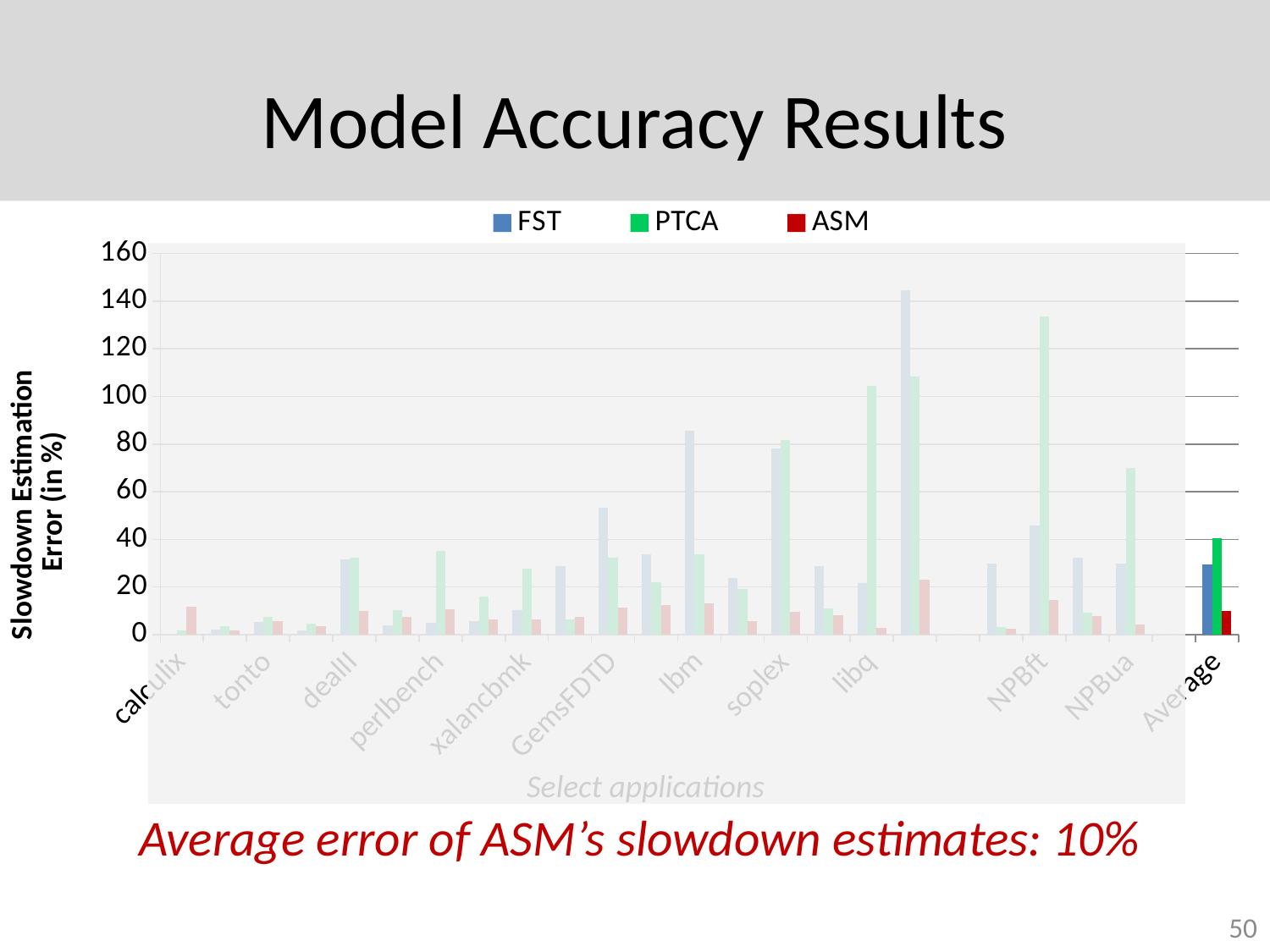
For the Average category, which series has the highest bar? PTCA For lbm, is the FST bar or the PTCA bar larger? FST What are the three series named in the legend? FST, PTCA, ASM Is the ASM value for calculix greater or less than 20? less How many series does the legend list? 3 Is the PTCA value for NPBft greater or less than 120? greater For the Average category, which series has the lowest bar? ASM Is the FST value for Average greater or less than 20? greater For the Average category, is the FST bar or the ASM bar larger? FST What is the y-axis title of the chart? Slowdown Estimation Error (in %) What kind of chart is shown on the slide? bar chart What is the average error of ASM's slowdown estimates, as stated on the slide? 10%